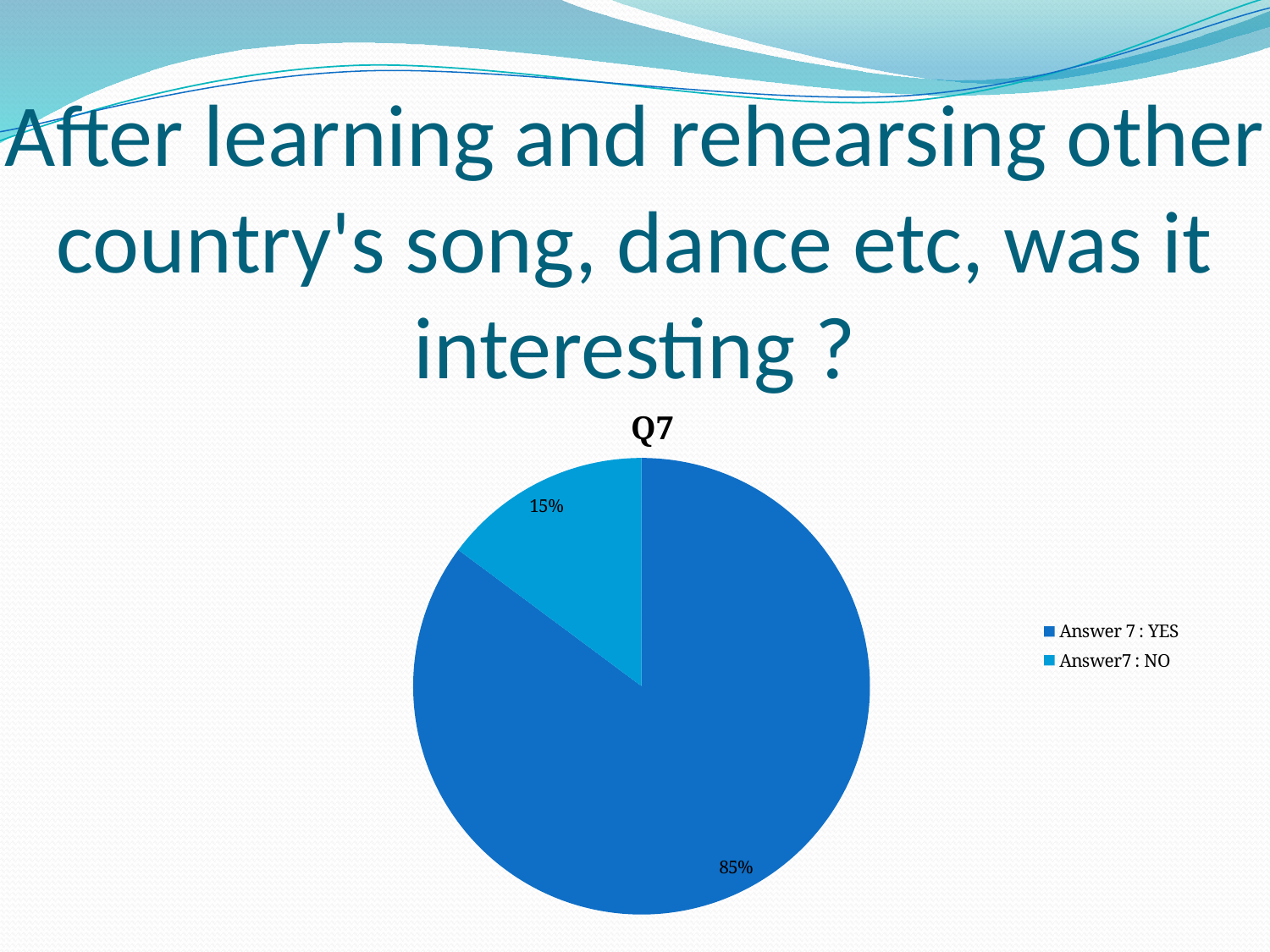
What is the title of the chart? Q7 Which slice of the pie is the largest? Answer 7 : YES What kind of chart is shown on the slide? pie chart Which slice of the pie is the smallest? Answer7 : NO What share of the pie does the NO slice represent? 15% What is the legend label for the darker blue slice? Answer 7 : YES What is the difference in percentage points between the YES slice and the NO slice? 70 Which is larger, the YES slice or the NO slice? Answer 7 : YES How many slices does the pie chart have? 2 How many entries does the legend list? 2 What percentage of the pie is labelled for Answer7 : NO? 15% What percentage of the pie is labelled for Answer 7 : YES? 85%